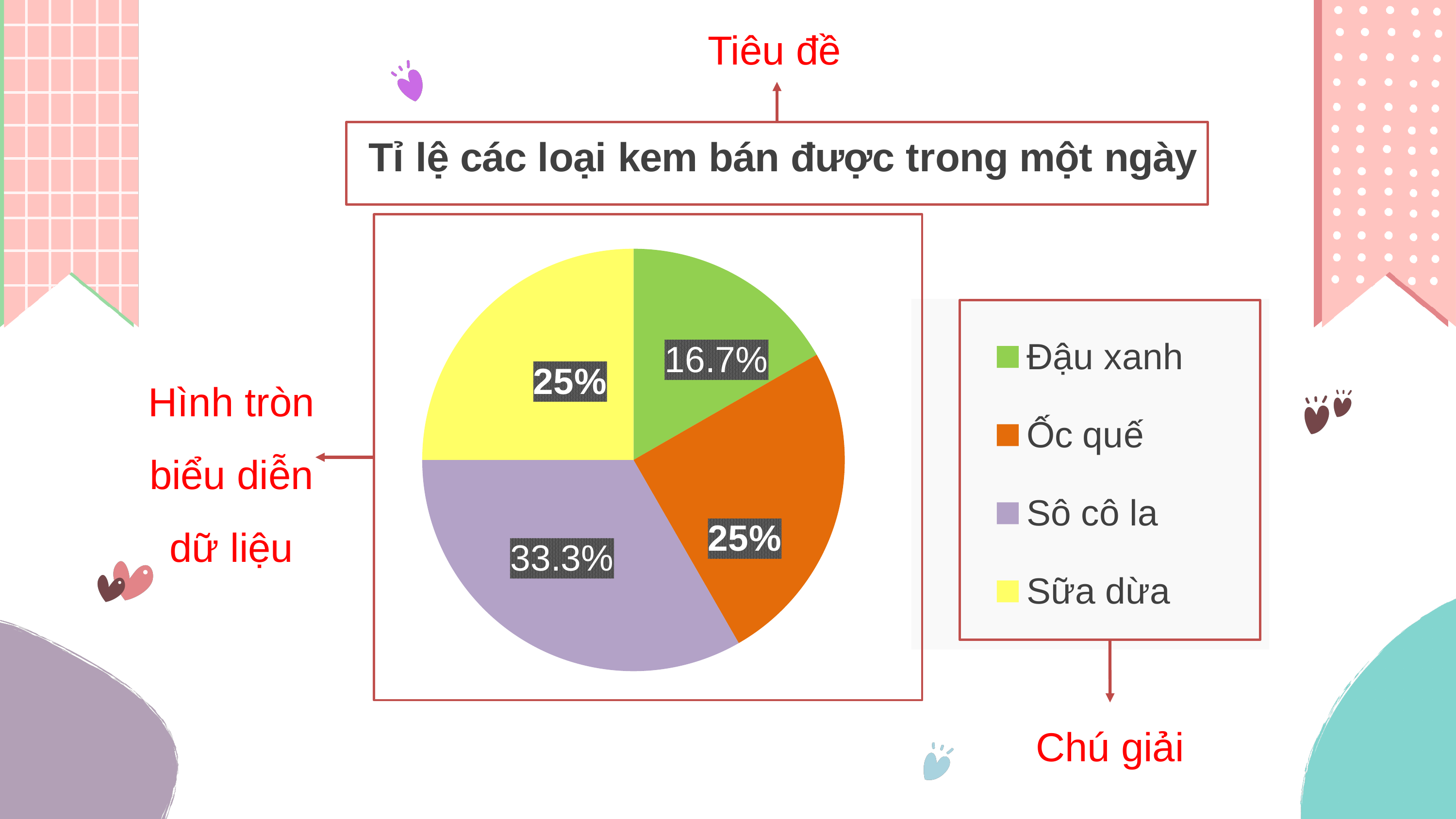
Which ice cream type has the smallest share of the pie? Đậu xanh How many categories does the pie chart show? 4 What percentage of the pie is Đậu xanh? 16.7% Which ice cream type has the largest share of the pie? Sô cô la Which colour represents Sữa dừa in the legend? Yellow What percentage of the pie is Sữa dừa? 25% What kind of chart is shown on the slide? Pie chart What is the difference in percentage points between Sô cô la and Đậu xanh? 16.6 Which is larger, the share for Sô cô la or the share for Ốc quế? Sô cô la What is the title of the chart? Tỉ lệ các loại kem bán được trong một ngày What percentage of the pie is Sô cô la? 33.3% What percentage of the pie is Ốc quế? 25%